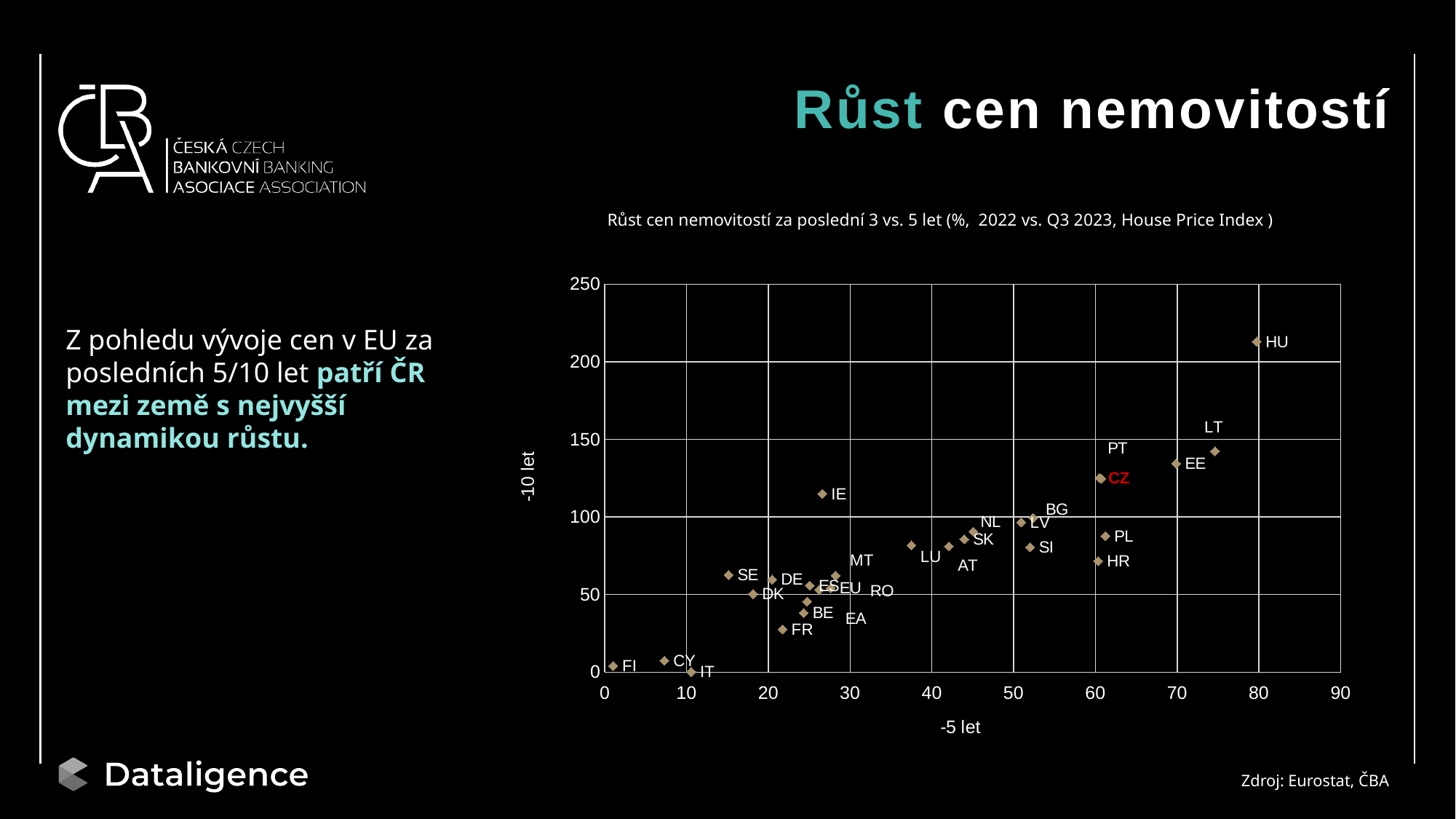
Which country label is highlighted in red on the chart? CZ Is the -5 let value for CZ greater or less than 50? greater Which country has the lowest value on the -5 let axis? FI Is the -10 let value for FR greater or less than 50? less What kind of chart is shown on the slide? scatter chart Is the -10 let value for HU greater or less than 200? greater Which has a higher -10 let value, CZ or HR? CZ Which country has the highest value on the -10 let axis? HU Which country has the lowest value on the -10 let axis? IT Which country has the highest value on the -5 let axis? HU What is the label of the horizontal axis? -5 let